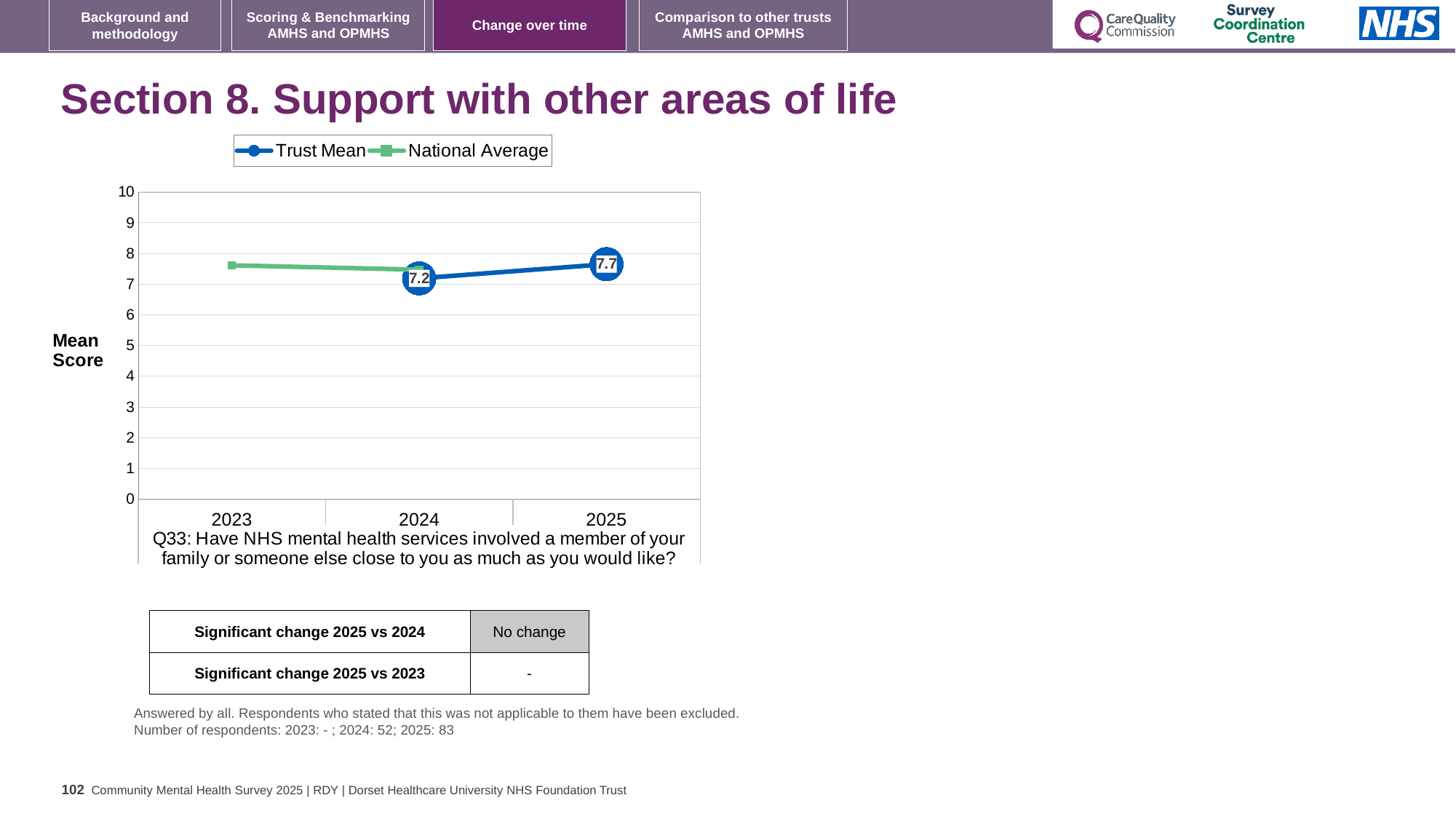
Is the National Average value for 2023 greater or less than 7? greater What kind of chart is shown on the slide? line chart Does the Trust Mean rise or fall from 2024 to 2025? rise Which year has the higher Trust Mean, 2024 or 2025? 2025 What is the Trust Mean value for 2025? 7.7 By how much did the Trust Mean change from 2024 to 2025? 0.5 What is the Trust Mean value for 2024? 7.2 How many years are shown on the x axis? 3 How many series does the legend list? 2 In which year is the Trust Mean highest? 2025 Is the National Average value for 2024 greater or less than 8? less What is the label on the y axis of the chart? Mean Score